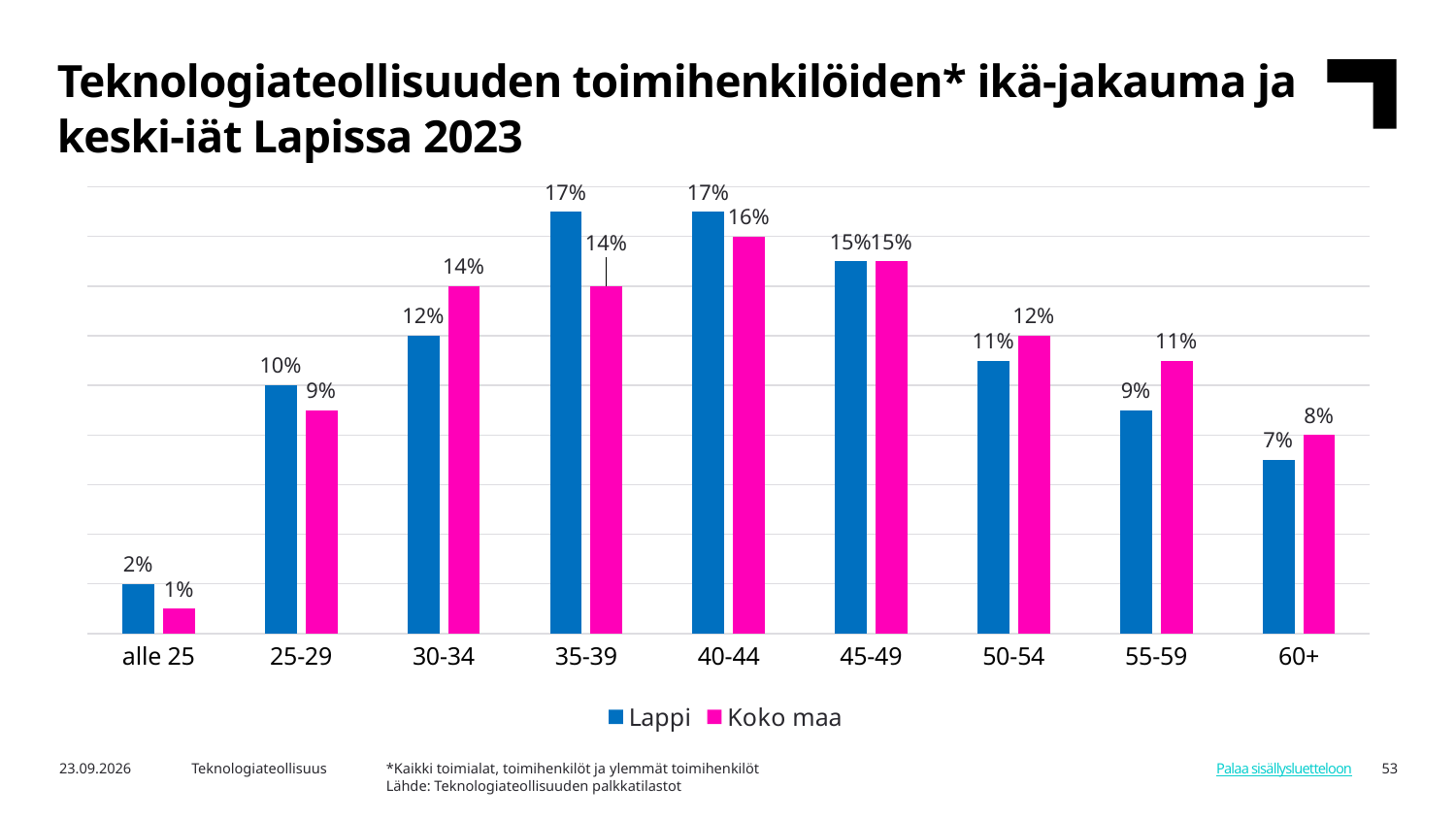
In the 25-29 age group, which series has the larger value, Lappi or Koko maa? Lappi Which age group has the lowest value for Lappi? alle 25 What is the value for Lappi in the 60+ age group? 7% In the 50-54 age group, which series has the larger value, Lappi or Koko maa? Koko maa How many age groups are shown on the x axis? 9 What kind of chart is shown on the slide? Bar chart What is the value for Lappi in the 30-34 age group? 12% Do the Lappi values rise or fall from the 45-49 age group to the 60+ age group? Fall What is the value for Koko maa in the 55-59 age group? 11% What is the difference between the Lappi and Koko maa values in the 35-39 age group? 3 percentage points How many series does the legend list? 2 Which age group has the highest value for Koko maa? 40-44